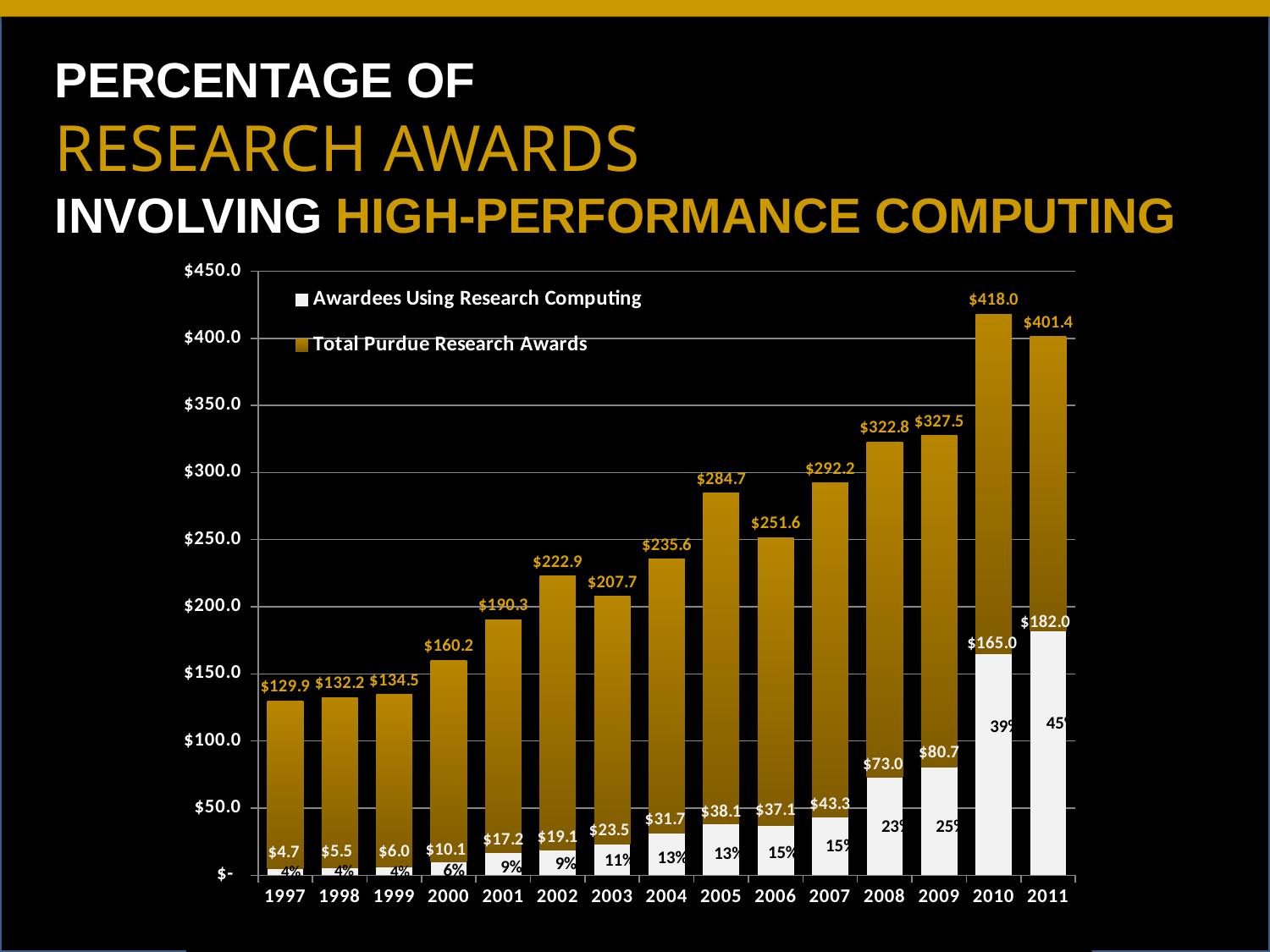
How many years are shown on the x axis? 15 What kind of chart is shown on the slide? Bar chart What is the value of Total Purdue Research Awards for 2005? $284.7 Which year has the highest Total Purdue Research Awards? 2010 What percentage is shown on the Awardees Using Research Computing bar for 2004? 13% Which year has the lowest Total Purdue Research Awards? 1997 Do the Awardees Using Research Computing values generally rise or fall from 1997 to 2011? Rise Which year has the larger Total Purdue Research Awards, 2002 or 2003? 2002 What is the difference between Total Purdue Research Awards in 2010 and 2011? $16.6 What is the value of Awardees Using Research Computing for 2009? $80.7 How many series does the legend list? 2 What is the value of Awardees Using Research Computing for 1997? $4.7